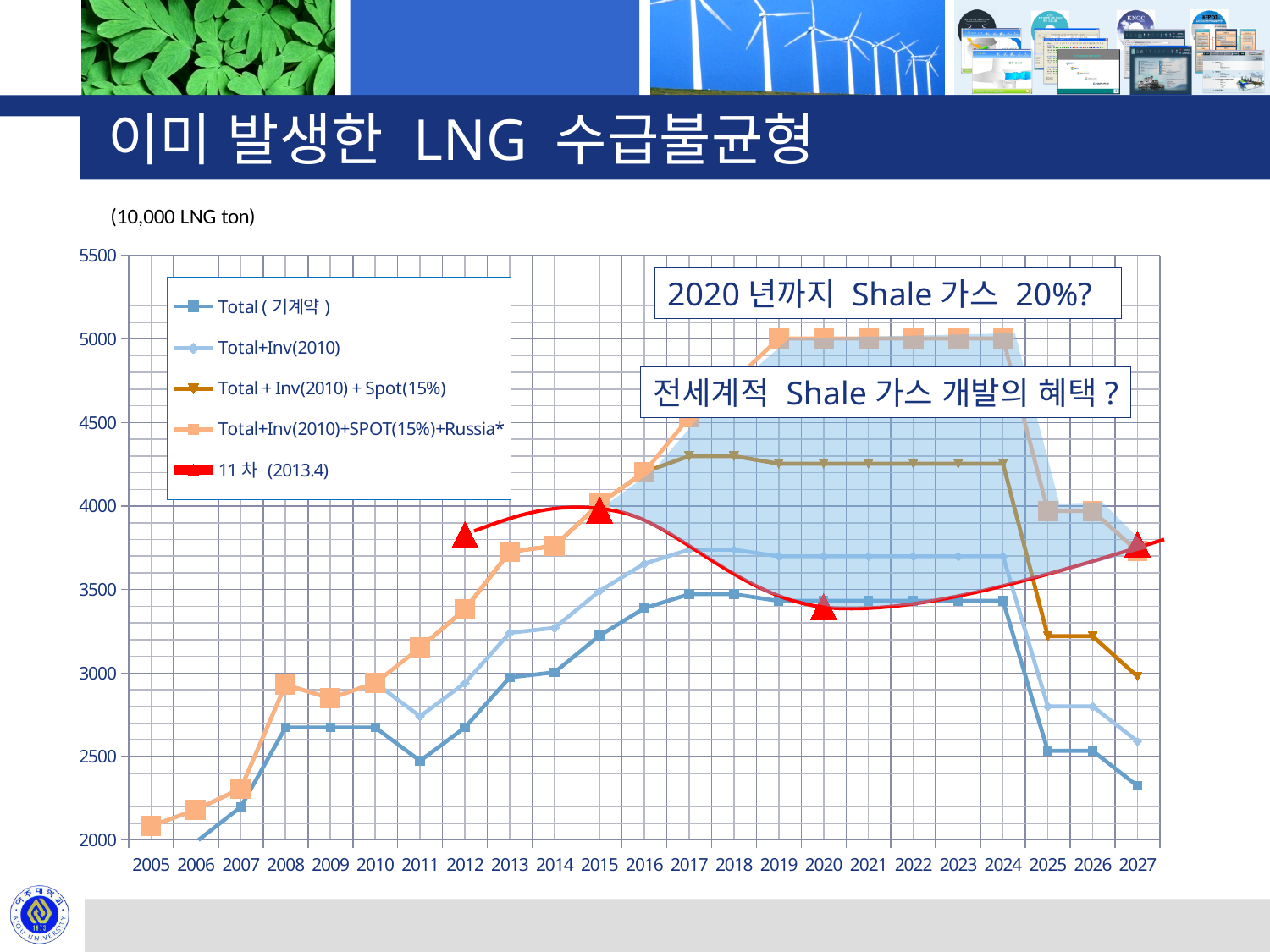
Is the value of the Total ( 기계약 ) series in 2027 greater or less than 2500? less In 2027, which series has the larger value: Total+Inv(2010)+SPOT(15%)+Russia* or Total ( 기계약 )? Total+Inv(2010)+SPOT(15%)+Russia* How many series does the chart legend list? 5 How many years are shown along the x axis of the chart? 23 In which year is the Total+Inv(2010)+SPOT(15%)+Russia* series at its lowest? 2005 Is the value of the Total + Inv(2010) + Spot(15%) series in 2027 greater or less than 2500? greater What kind of chart is shown on the slide? line chart Does the Total ( 기계약 ) series rise or fall from 2024 to 2027? fall What unit is given for the chart's values? 10,000 LNG ton Is the value of the Total ( 기계약 ) series in 2017 greater or less than 3000? greater